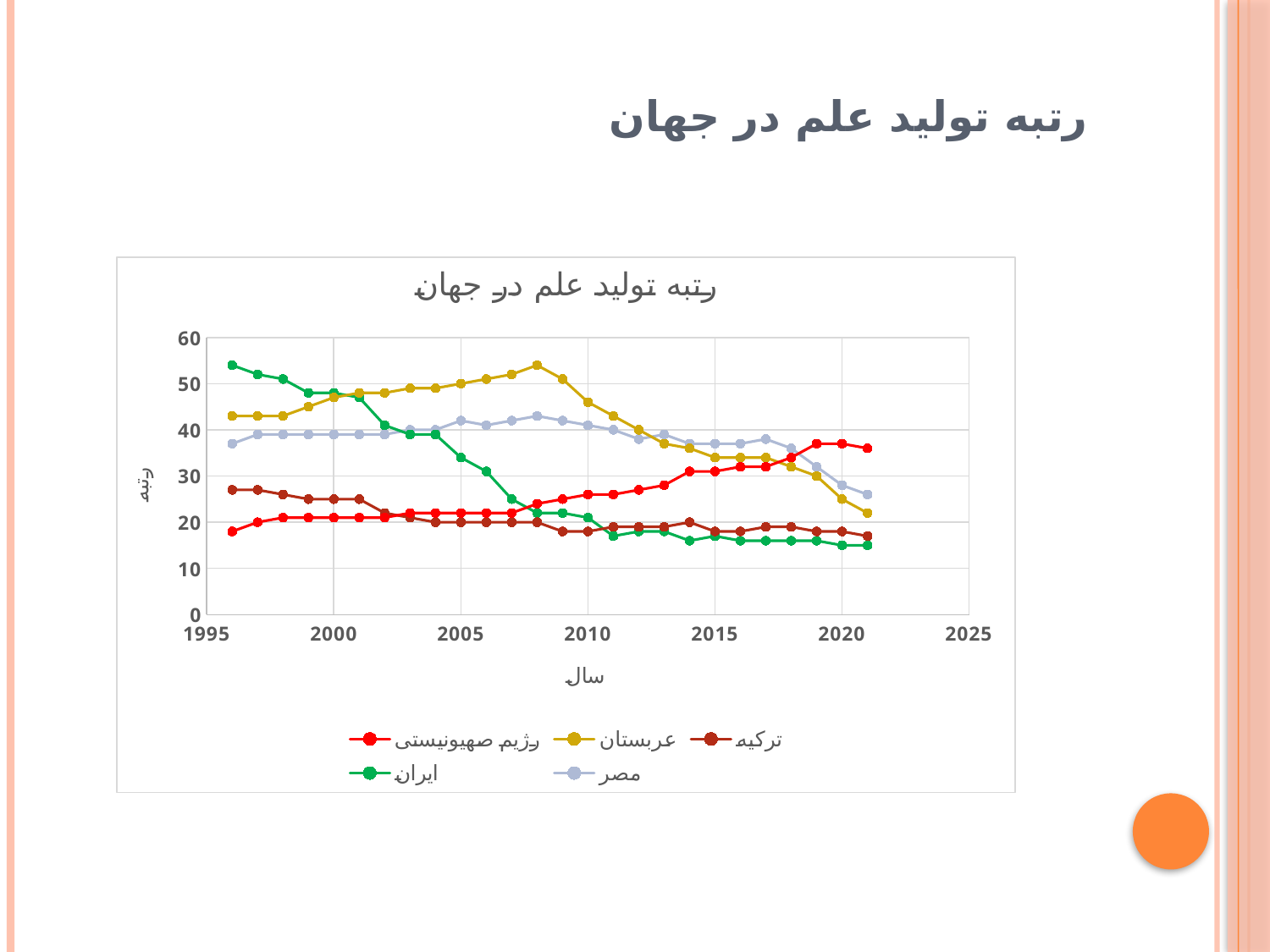
In 2021, which has the higher value, عربستان or ایران? عربستان Which series has the highest value in 2021? رژیم صهیونیستی Is the value for ایران in 1996 greater or less than 50? greater What is the title of the chart? رتبه تولید علم در جهان What is the label of the x axis? سال What kind of chart is shown on the slide? line chart Is the value for مصر in 2021 greater or less than 30? less Does the line for رژیم صهیونیستی rise or fall from 1996 to 2021? rise Which series has the highest value in 1996? ایران Is the value for عربستان in 2008 greater or less than 50? greater Does the line for ایران rise or fall from 1996 to 2021? fall How many series does the chart legend list? 5